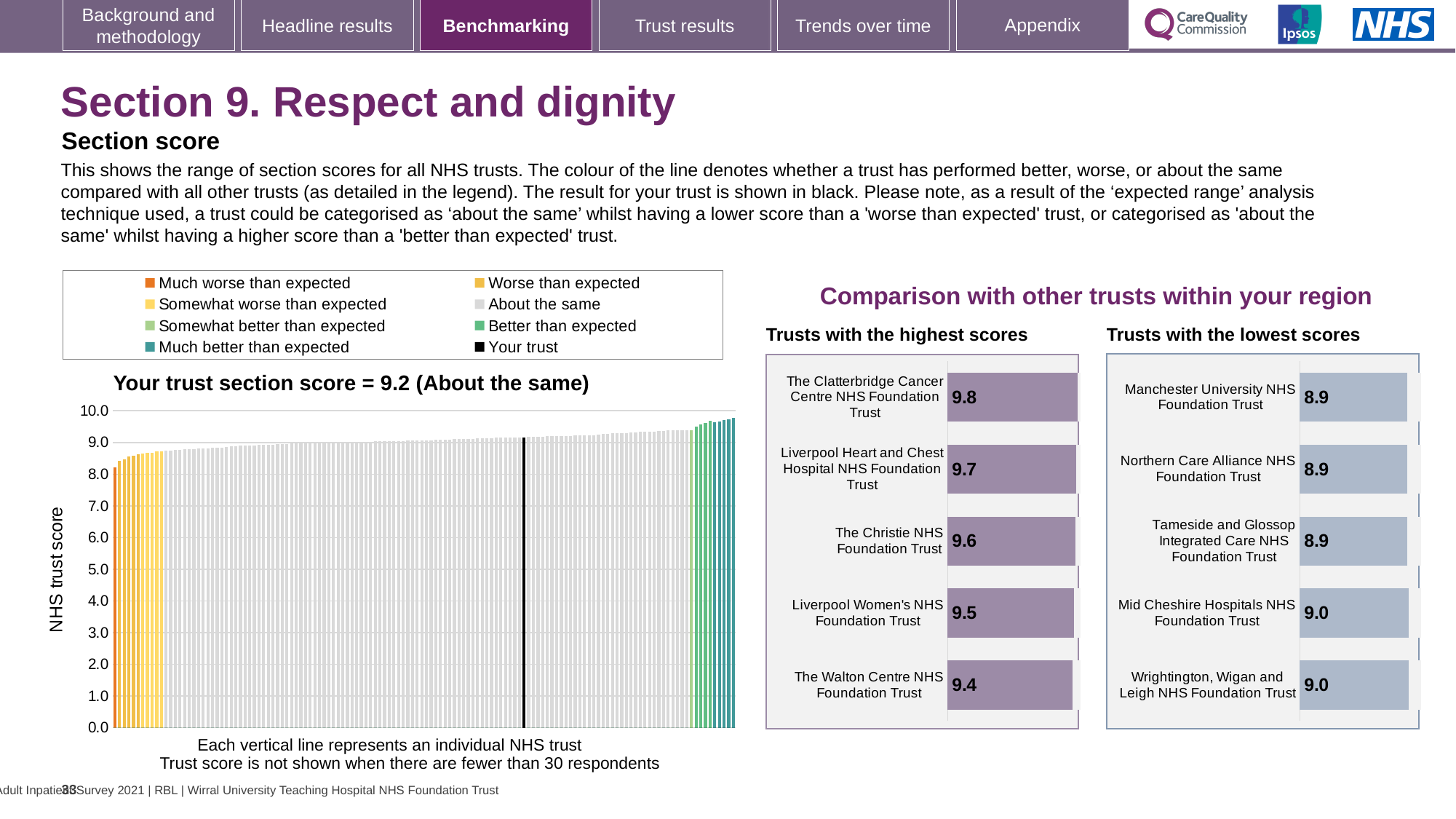
In the 'Your trust section score' chart, what is the section score for your trust? 9.2 In the 'Trusts with the highest scores' chart, what is the score for The Christie NHS Foundation Trust? 9.6 In the 'Trusts with the highest scores' chart, what is the difference between the scores of The Clatterbridge Cancer Centre NHS Foundation Trust and The Walton Centre NHS Foundation Trust? 0.4 How many entries does the legend above the 'Your trust section score' chart list? 8 In the 'Your trust section score' chart, do the bar values rise or fall from left to right? rise What is the y-axis label of the 'Your trust section score' chart? NHS trust score How many trusts are shown in the 'Trusts with the lowest scores' chart? 5 In the 'Your trust section score' chart, is the value of the leftmost bar greater or less than 9.0? less In the 'Trusts with the lowest scores' chart, what is the score for Mid Cheshire Hospitals NHS Foundation Trust? 9.0 In the 'Trusts with the highest scores' chart, which trust has the highest score? The Clatterbridge Cancer Centre NHS Foundation Trust What kind of chart is the 'Your trust section score' chart? bar chart In the 'Trusts with the lowest scores' chart, which has the larger score: Manchester University NHS Foundation Trust or Wrightington, Wigan and Leigh NHS Foundation Trust? Wrightington, Wigan and Leigh NHS Foundation Trust